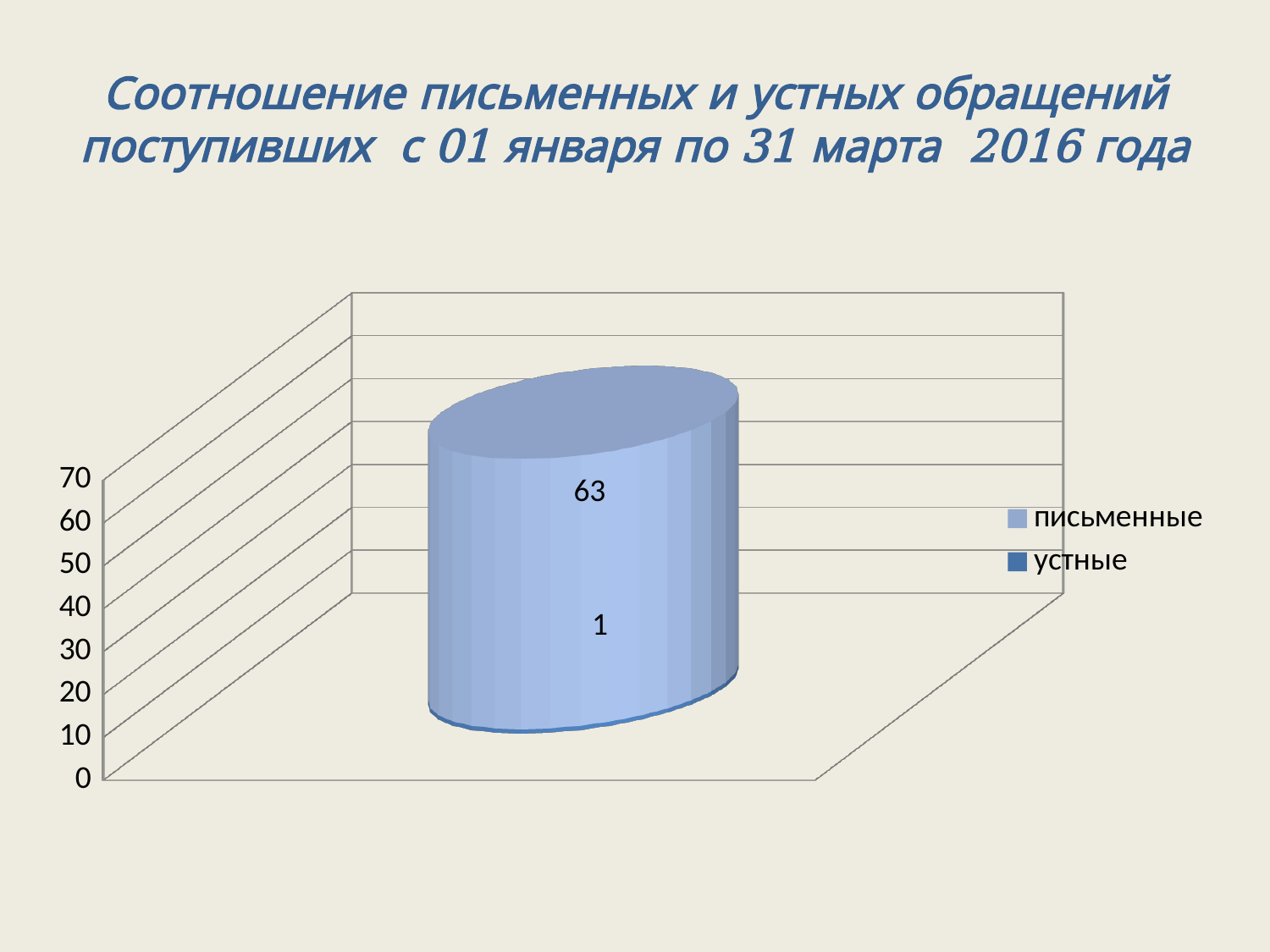
What kind of chart is shown on the slide? bar chart What is the difference between the values for письменные and устные? 62 How many series does the legend list? 2 Is the value for письменные greater or less than 50? greater What is the highest value shown on the vertical axis? 70 Which series has the lowest value? устные How many bars are plotted in the chart? 1 Which series has the higher value, письменные or устные? письменные What is the total of the stacked bar? 64 What is the title of the slide? Соотношение письменных и устных обращений поступивших с 01 января по 31 марта 2016 года What is the value for устные? 1 What is the value for письменные? 63